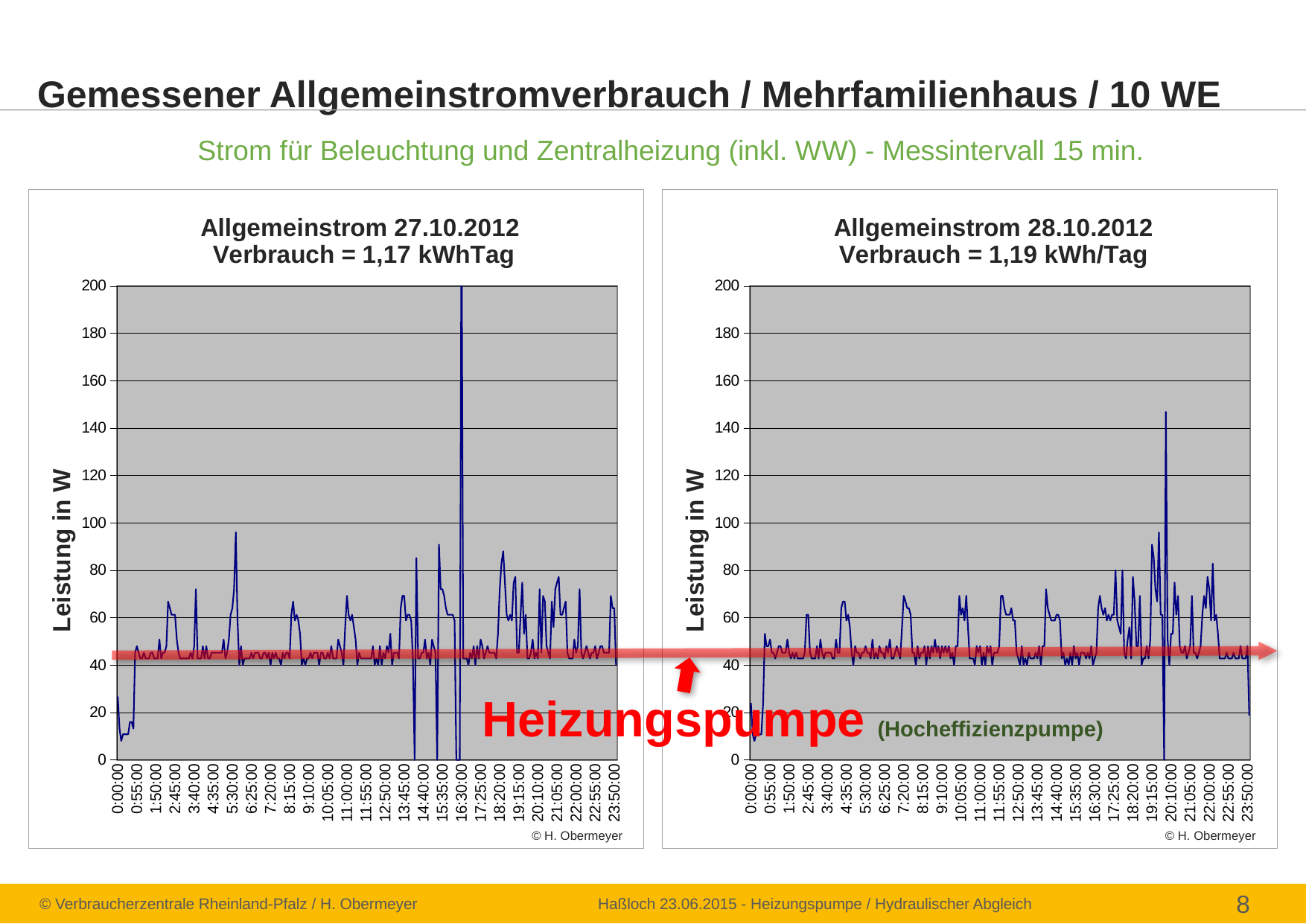
Which day has the higher stated daily consumption, 27.10.2012 or 28.10.2012? 28.10.2012 What is the last time label on the horizontal axis of the left chart, 'Allgemeinstrom 27.10.2012'? 23:50:00 On the right chart, 'Allgemeinstrom 28.10.2012', is the highest peak (around 20:10:00) greater or less than 160? less On the left chart, 'Allgemeinstrom 27.10.2012', is the value at 0:00:00 greater or less than 40? less On the left chart, 'Allgemeinstrom 27.10.2012', is the peak value around 16:30:00 greater or less than 140? greater What daily consumption is stated in the title of the right chart, 'Allgemeinstrom 28.10.2012'? 1,19 kWh/Tag What is the label of the vertical axis on the right chart, 'Allgemeinstrom 28.10.2012'? Leistung in W What is the maximum value shown on the vertical axis of the left chart, 'Allgemeinstrom 27.10.2012'? 200 What kind of chart is the left chart, 'Allgemeinstrom 27.10.2012'? Line chart Which chart shows the higher maximum peak, the left chart (27.10.2012) or the right chart (28.10.2012)? Left chart (27.10.2012) What is the first time label on the horizontal axis of the right chart, 'Allgemeinstrom 28.10.2012'? 0:00:00